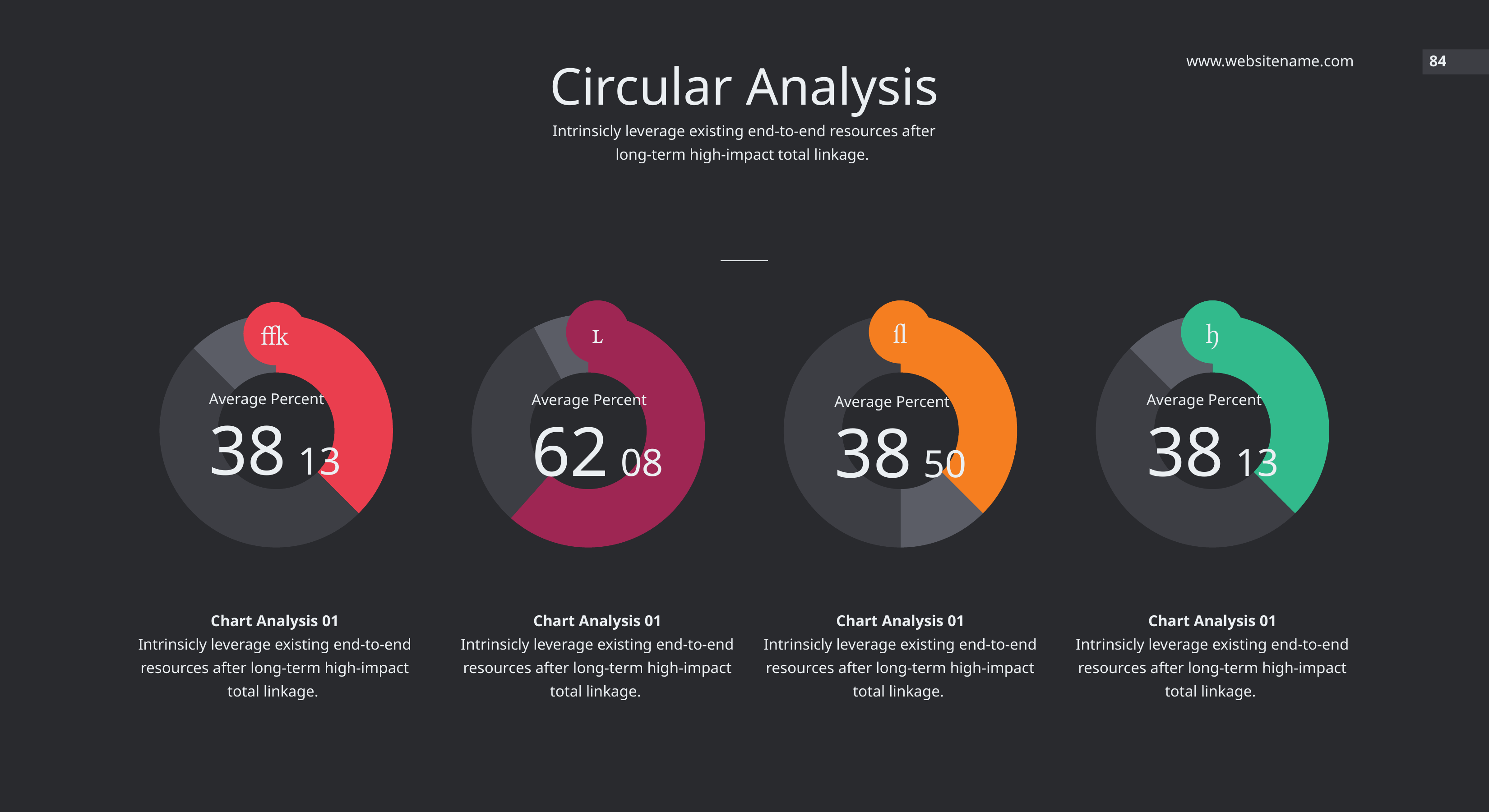
Is the large centre number of the second (magenta) chart larger or smaller than that of the leftmost (red) chart? Larger What large number is printed in the centre of the leftmost (red) chart? 38 What kind of chart is used for each of the four figures on the slide? Doughnut (ring) chart What large number is printed in the centre of the third (orange) chart? 38 What is the difference between the large centre numbers of the second (magenta) chart and the third (orange) chart? 24 What label appears above the number in the centre of each chart? Average Percent Which of the four charts shows the highest large centre number? The second (magenta) chart What large number is printed in the centre of the second (magenta) chart? 62 How many circular charts are shown on the slide? 4 What colour is the highlighted ring segment of the rightmost chart? Green What smaller number follows the large number in the centre of the second (magenta) chart? 08 What smaller number follows the large number in the centre of the third (orange) chart? 50